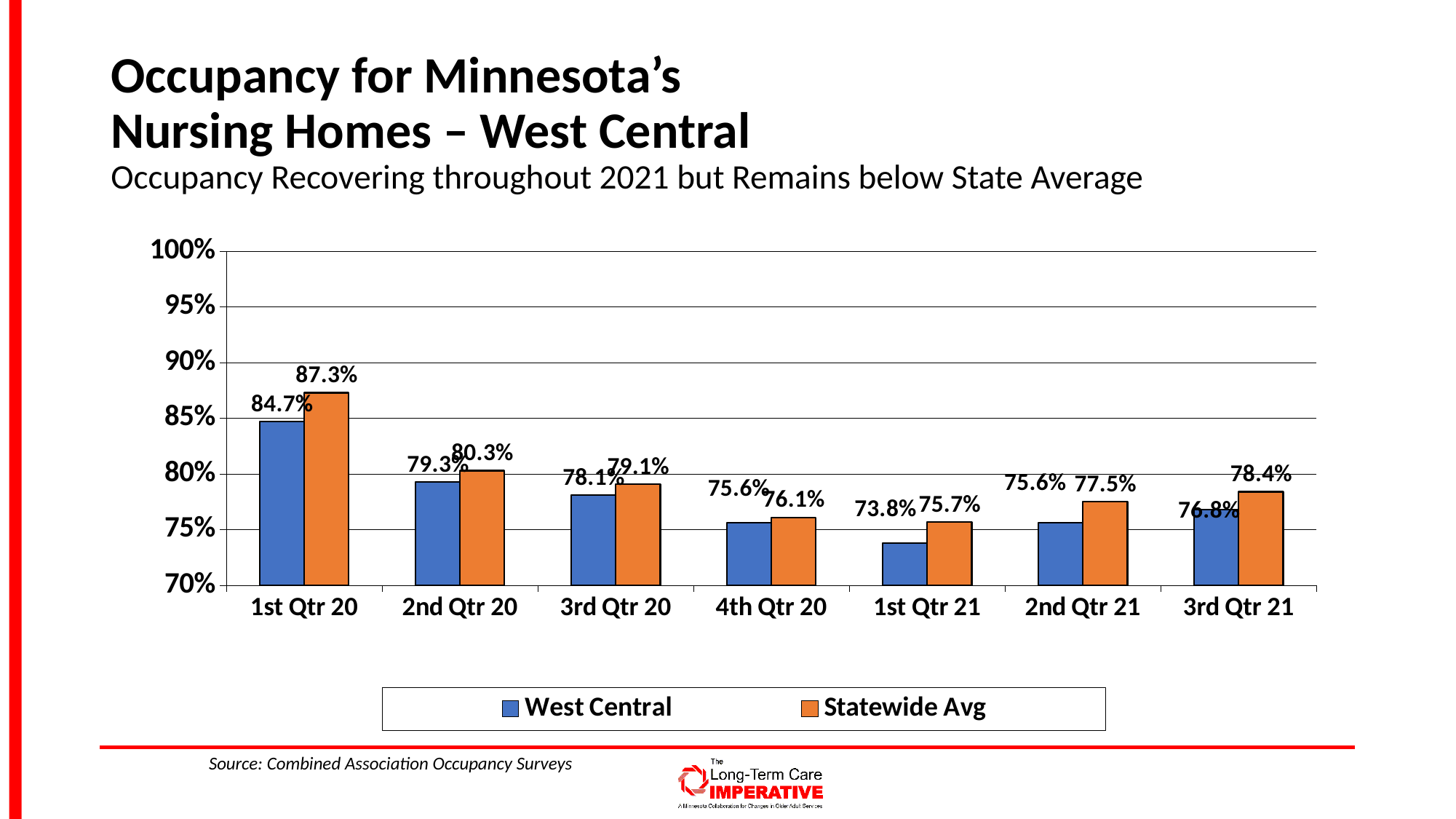
Which is larger in 2nd Qtr 21: West Central or Statewide Avg occupancy? Statewide Avg In which quarter is the West Central occupancy lowest? 1st Qtr 21 What is the West Central occupancy value for 1st Qtr 20? 84.7% What is the Statewide Avg occupancy value for 3rd Qtr 21? 78.4% What kind of chart is shown on the slide? Bar chart What is the Statewide Avg occupancy value for 2nd Qtr 21? 77.5% What is the West Central occupancy value for 1st Qtr 21? 73.8% How many series does the legend list? 2 In which quarter is the Statewide Avg occupancy highest? 1st Qtr 20 What is the difference between the Statewide Avg and West Central occupancy in 1st Qtr 20? 2.6% Which colour represents the Statewide Avg series? Orange How many quarters are shown on the x axis? 7